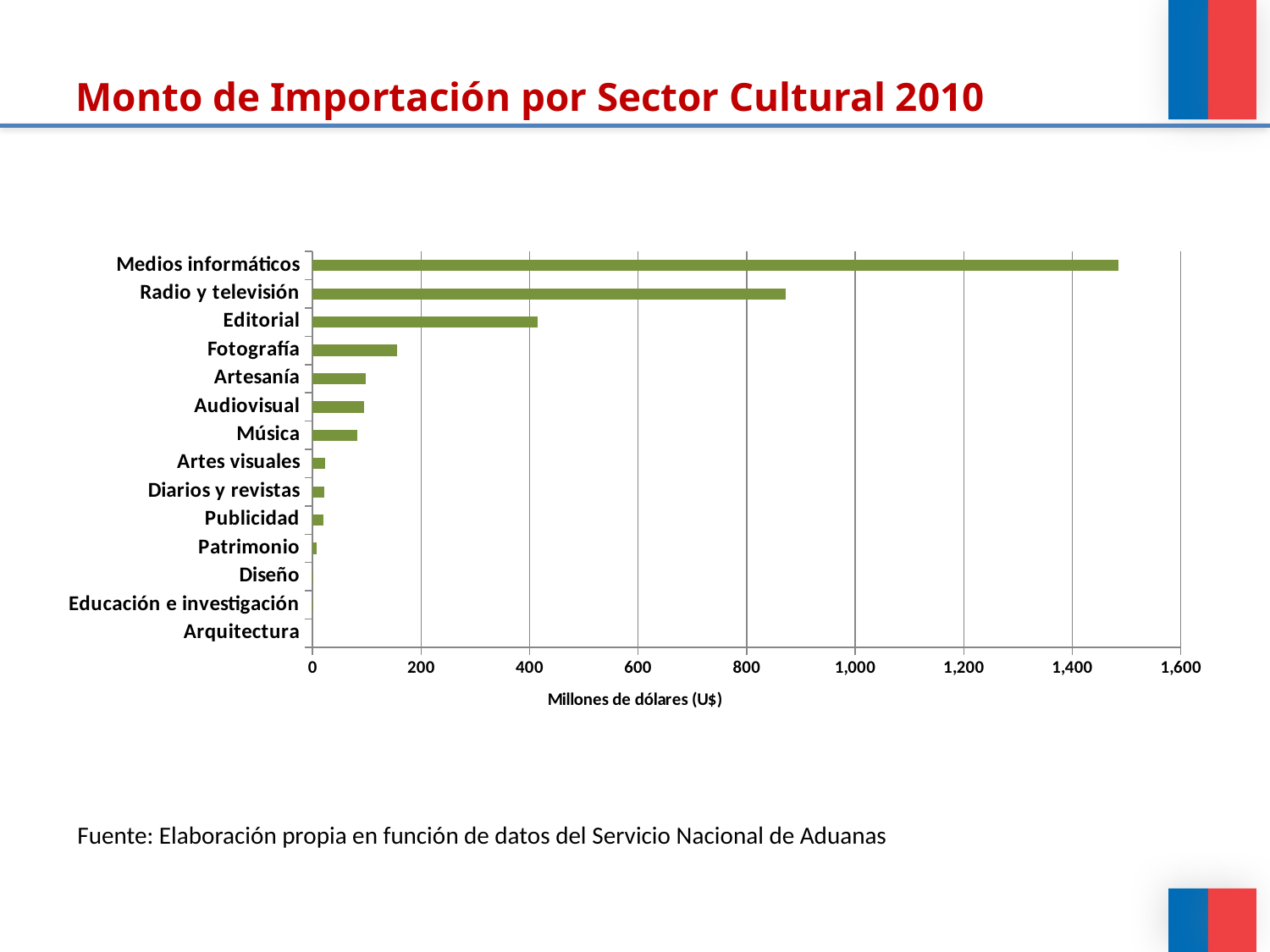
What is the label of the horizontal axis? Millones de dólares (U$) What is the title of the chart on the slide? Monto de Importación por Sector Cultural 2010 Which sector has the highest import amount? Medios informáticos Which is larger, the value for Fotografía or the value for Música? Fotografía How many sectors (categories) are listed on the chart? 14 Is the value for Fotografía greater or less than 200? less Is the value for Medios informáticos greater or less than 1,400? greater Which is larger, the value for Radio y televisión or the value for Editorial? Radio y televisión What kind of chart is shown on the slide? bar chart Which is larger, the value for Editorial or the value for Artesanía? Editorial Is the value for Radio y televisión greater or less than 800? greater